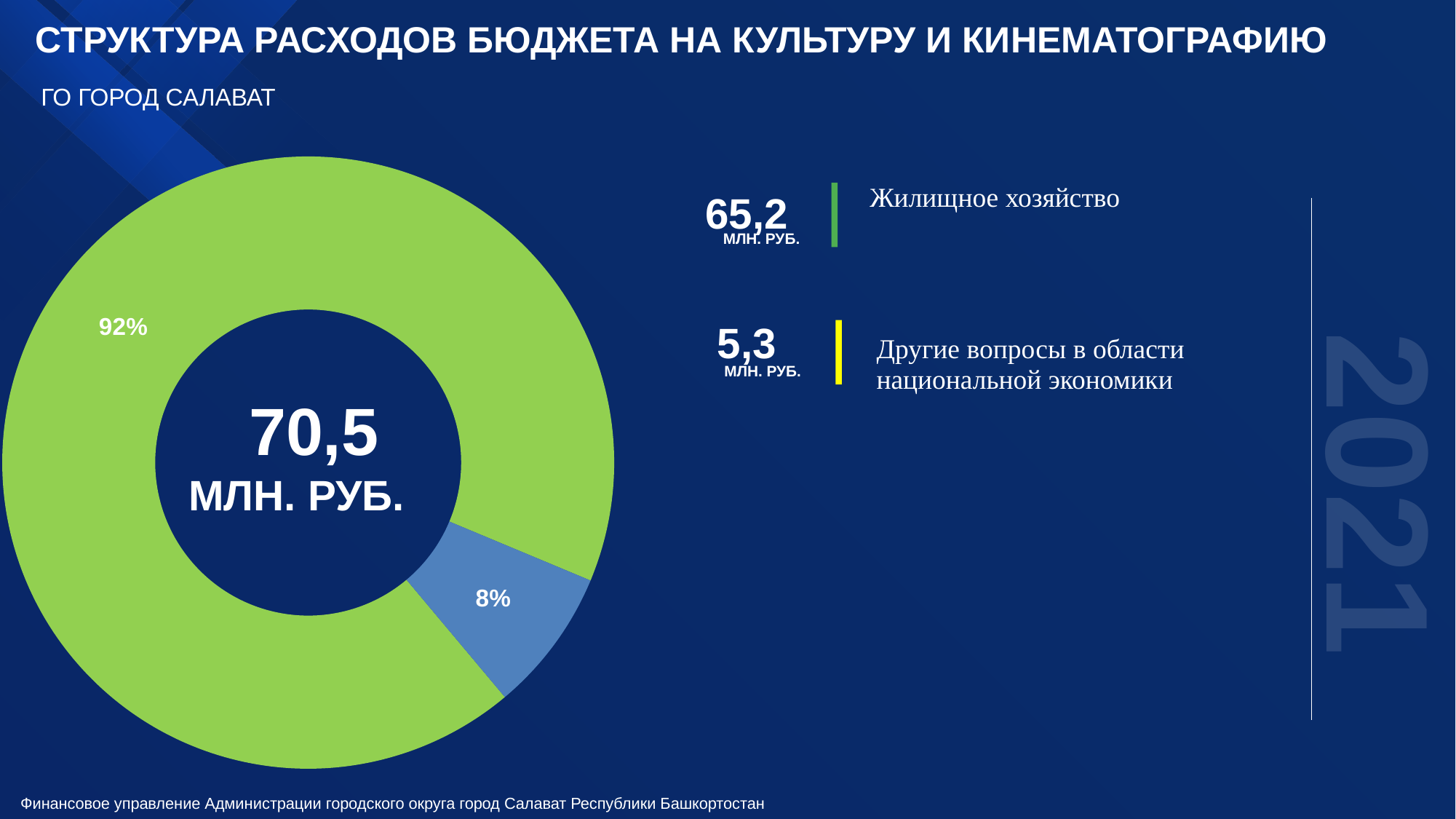
Which category has the highest value? Жилищное хозяйство What is the value shown for Жилищное хозяйство? 65,2 млн. руб. What share of the chart does the largest slice represent? 92% How many slices does the donut chart have? 2 What is the title of the slide? СТРУКТУРА РАСХОДОВ БЮДЖЕТА НА КУЛЬТУРУ И КИНЕМАТОГРАФИЮ What total value is shown in the centre of the donut chart? 70,5 млн. руб. What share of the chart does the smallest slice represent? 8% What is the difference between the values for Жилищное хозяйство and Другие вопросы в области национальной экономики? 59,9 млн. руб. What kind of chart is shown on the slide? Pie (donut) chart What is the value shown for Другие вопросы в области национальной экономики? 5,3 млн. руб. Which category has the lowest value? Другие вопросы в области национальной экономики Which is larger: Жилищное хозяйство or Другие вопросы в области национальной экономики? Жилищное хозяйство